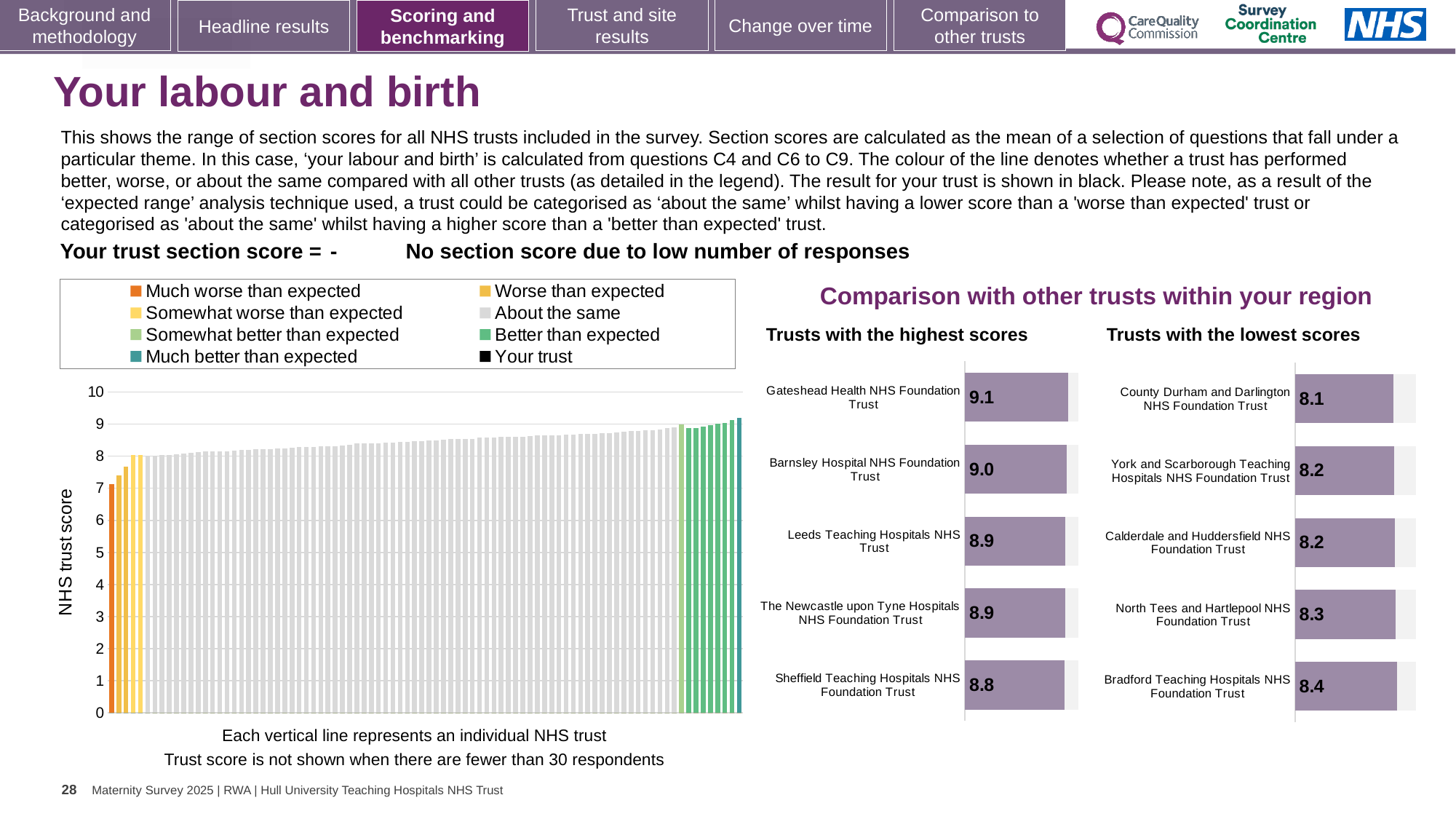
In the large chart on the left, do the NHS trust scores rise or fall from left to right? Rise In the large chart on the left, is the value of the tallest bar greater or less than 9? greater In the 'Trusts with the lowest scores' chart, what is the score for Bradford Teaching Hospitals NHS Foundation Trust? 8.4 In the 'Trusts with the highest scores' chart, what is the score for Sheffield Teaching Hospitals NHS Foundation Trust? 8.8 In the 'Trusts with the highest scores' chart, what is the score for Gateshead Health NHS Foundation Trust? 9.1 How many entries does the legend of the large chart on the left list? 8 What kind of chart is the large chart on the left showing NHS trust scores? Bar chart How many trusts are listed in the 'Trusts with the lowest scores' chart? 5 In the 'Trusts with the lowest scores' chart, which trust has the lowest score? County Durham and Darlington NHS Foundation Trust In the 'Trusts with the highest scores' chart, which trust has the highest score? Gateshead Health NHS Foundation Trust In the 'Trusts with the highest scores' chart, which has the higher score: Barnsley Hospital NHS Foundation Trust or Leeds Teaching Hospitals NHS Trust? Barnsley Hospital NHS Foundation Trust In the 'Trusts with the highest scores' chart, what is the difference between the scores of Gateshead Health NHS Foundation Trust and Sheffield Teaching Hospitals NHS Foundation Trust? 0.3